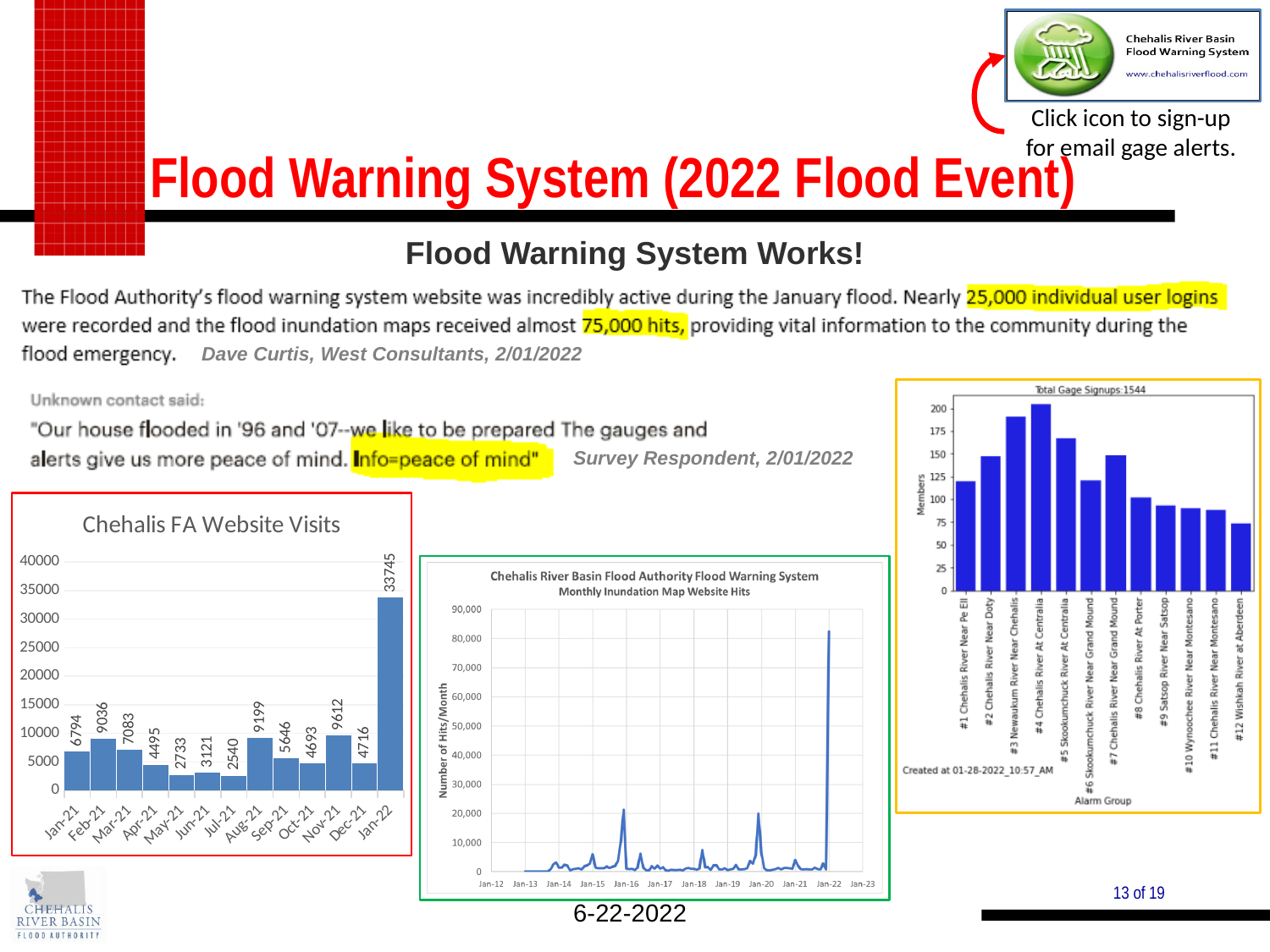
In the Chehalis FA Website Visits chart, which is larger, the value for Aug-21 or the value for Sep-21? Aug-21 In the Chehalis FA Website Visits chart, what is the value for Jan-22? 33745 In the Chehalis FA Website Visits chart, what is the difference between the Feb-21 and Jan-21 values? 2242 In the Total Gage Signups chart, is the value for #1 Chehalis River Near Pe Ell greater or less than 100? greater What kind of chart is the Chehalis FA Website Visits chart? Bar chart In the Monthly Inundation Map Website Hits chart, is the peak value near Jan-22 greater or less than 70,000? greater What kind of chart is the Monthly Inundation Map Website Hits chart? Line chart In the Chehalis FA Website Visits chart, which month has the lowest number of visits? Jul-21 In the Chehalis FA Website Visits chart, what is the value for Nov-21? 9612 In the Chehalis FA Website Visits chart, which month has the highest number of visits? Jan-22 In the Total Gage Signups chart, which alarm group has the most members? #4 Chehalis River At Centralia How many months are shown in the Chehalis FA Website Visits chart? 13